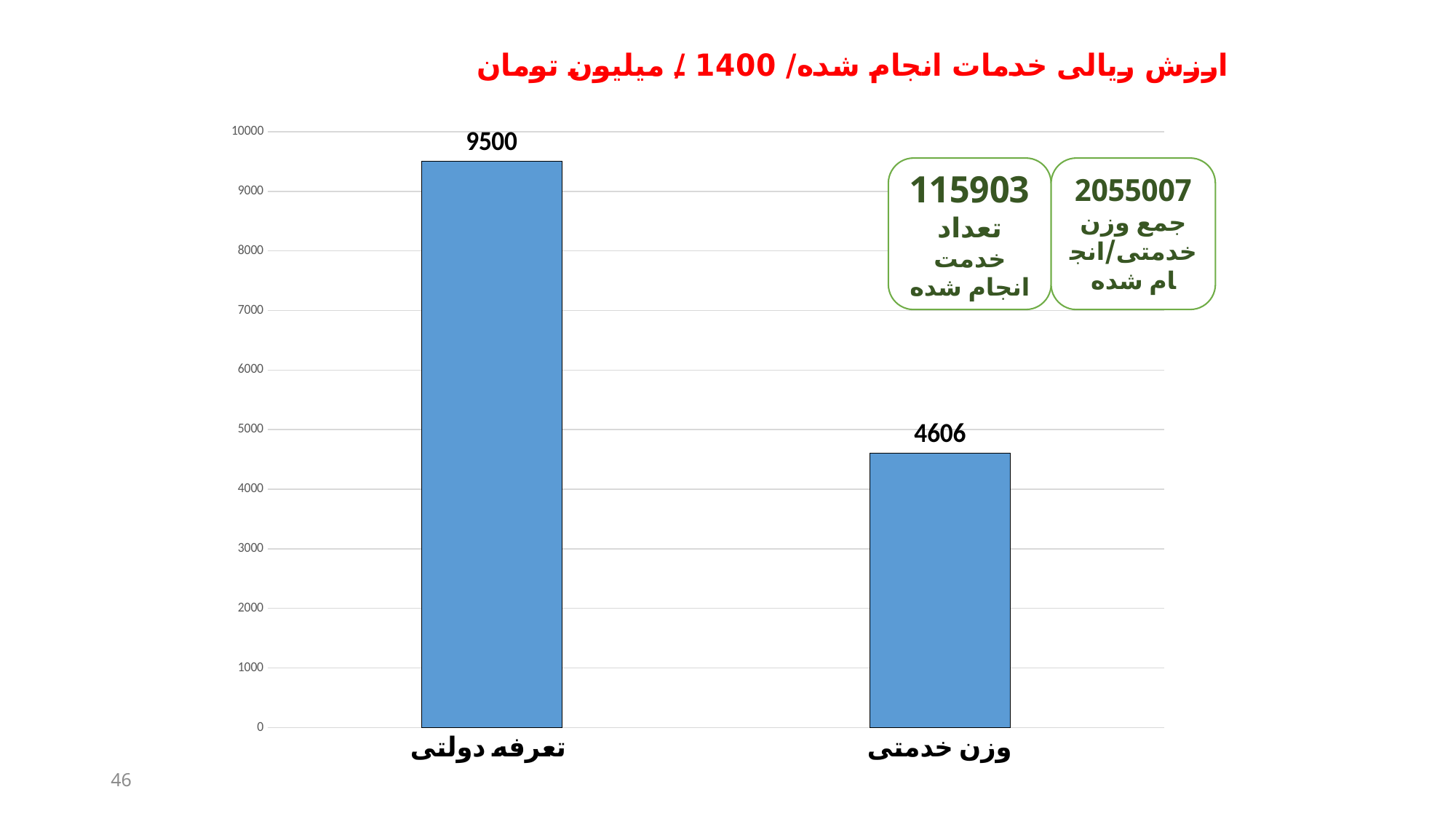
What is the highest value shown on the vertical axis? 10000 Which is larger, the value for تعرفه دولتی or the value for وزن خدمتی? تعرفه دولتی Which category has the highest value? تعرفه دولتی What is the value for تعرفه دولتی? 9500 What is the difference between the values for تعرفه دولتی and وزن خدمتی? 4894 What kind of chart is shown on the slide? bar chart How many categories are shown in the chart? 2 Is the value for وزن خدمتی greater or less than 5000? less Which category has the lowest value? وزن خدمتی Is the value for تعرفه دولتی greater or less than 9000? greater What is the value for وزن خدمتی? 4606 What is the title of the chart? ارزش ریالی خدمات انجام شده/ 1400 / میلیون تومان